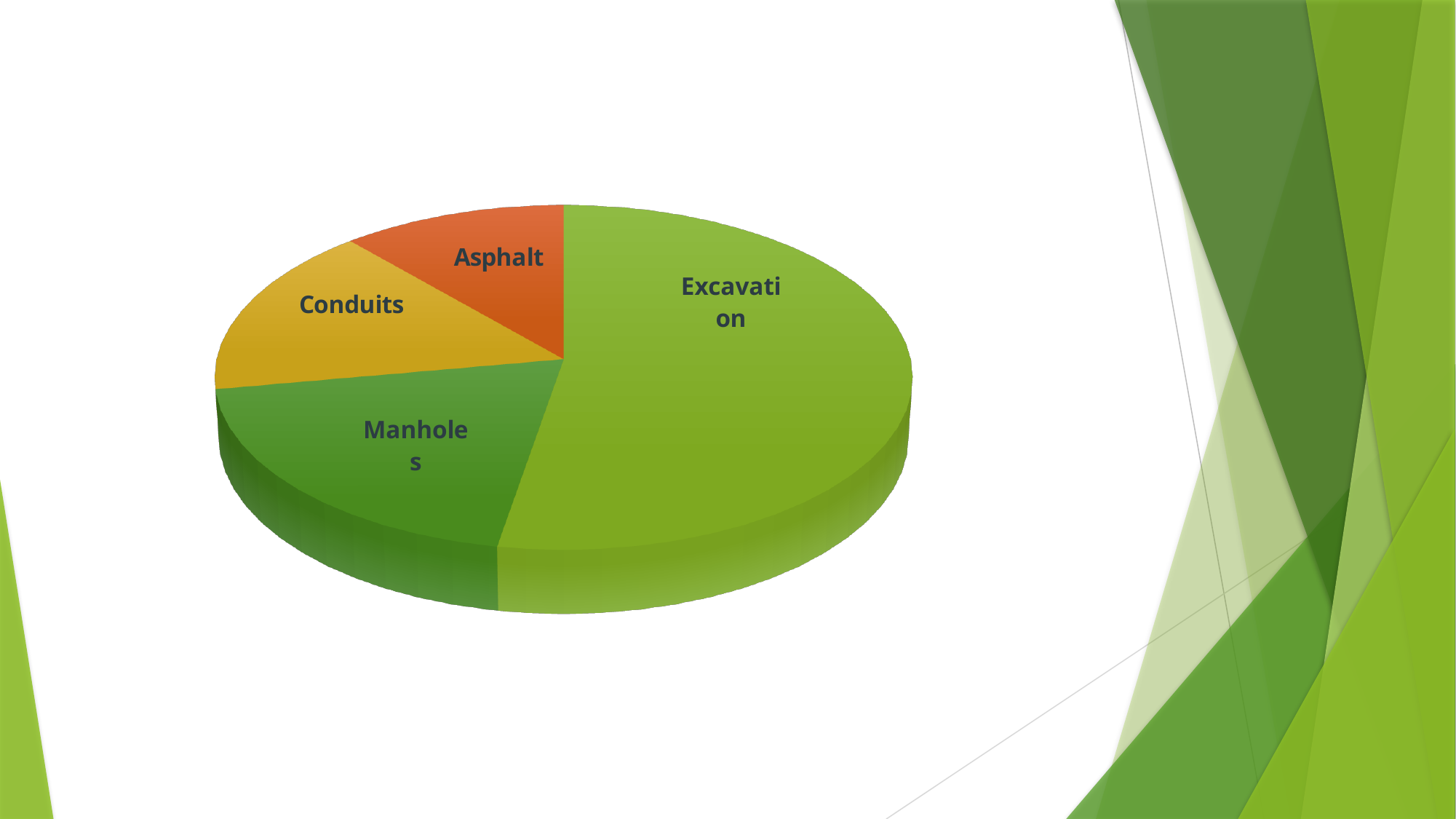
How many slices does the pie chart have? 4 What colour is the Conduits slice of the pie chart? yellow What kind of chart is shown on the slide? pie chart Which slice is larger, Manholes or Asphalt? Manholes Which slice is larger, Conduits or Asphalt? Conduits What colour is the Asphalt slice of the pie chart? orange Which category has the smallest slice of the pie chart? Asphalt Which category has the largest slice of the pie chart? Excavation Which slice is larger, Manholes or Conduits? Manholes